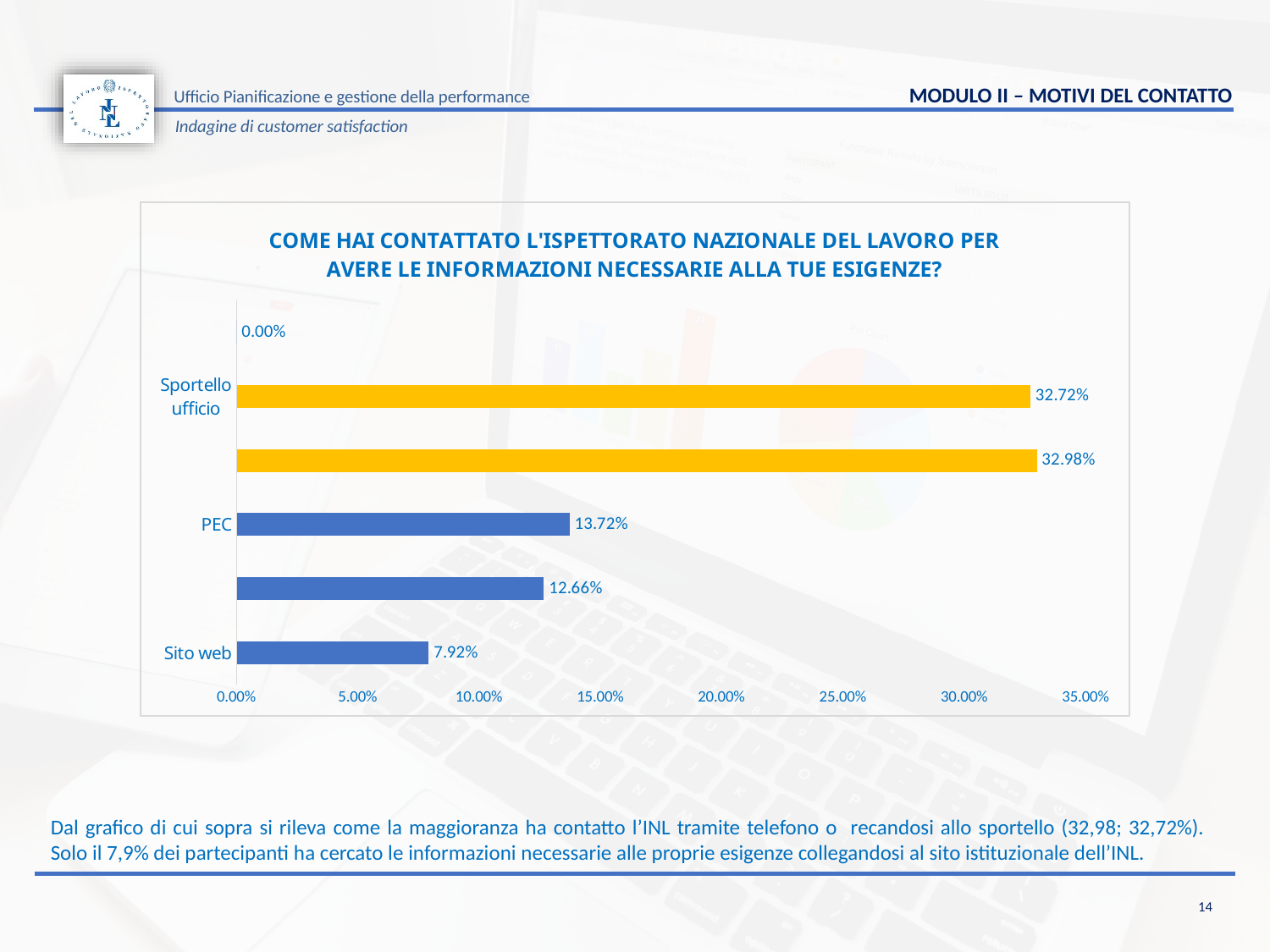
What is the difference between the values for PEC and Sito web? 5.80% What is the difference between the values for Sportello ufficio and PEC? 19.00% Which has a larger value, PEC or Sito web? PEC Is the value for Sportello ufficio greater or less than 30.00%? greater What is the value for PEC? 13.72% What is the value for Sito web? 7.92% What is the highest value shown in the chart? 32.98% What type of chart is shown on the slide? bar chart What colour are the two longest bars in the chart? yellow How many bars are plotted in the chart? 6 What is the lowest value shown in the chart? 0.00% What is the value for Sportello ufficio? 32.72%